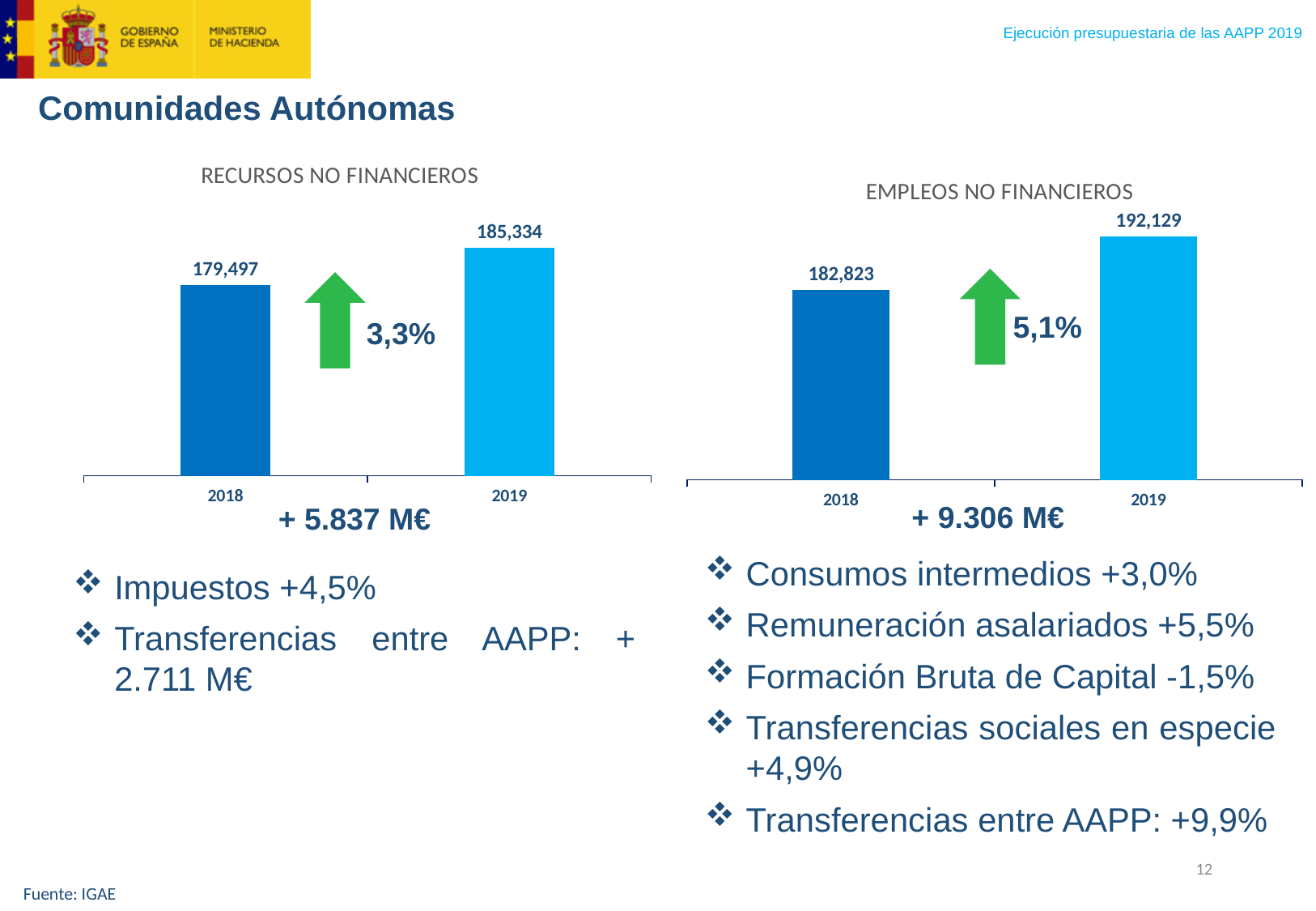
In the EMPLEOS NO FINANCIEROS chart, what is the value for 2018? 182,823 In the RECURSOS NO FINANCIEROS chart, what is the difference between the 2019 and 2018 values? 5,837 In the EMPLEOS NO FINANCIEROS chart, what is the value for 2019? 192,129 In the EMPLEOS NO FINANCIEROS chart, which year has the lower value? 2018 In the EMPLEOS NO FINANCIEROS chart, what is the difference between the 2019 and 2018 values? 9,306 How many bars are shown in the RECURSOS NO FINANCIEROS chart? 2 In the RECURSOS NO FINANCIEROS chart, which year has the higher value? 2019 In the RECURSOS NO FINANCIEROS chart, what is the value for 2019? 185,334 What type of chart is the EMPLEOS NO FINANCIEROS chart? bar chart In the RECURSOS NO FINANCIEROS chart, what is the value for 2018? 179,497 What percentage change is shown between the bars in the EMPLEOS NO FINANCIEROS chart? 5,1% Is the 2019 value in the EMPLEOS NO FINANCIEROS chart larger or smaller than the 2019 value in the RECURSOS NO FINANCIEROS chart? larger